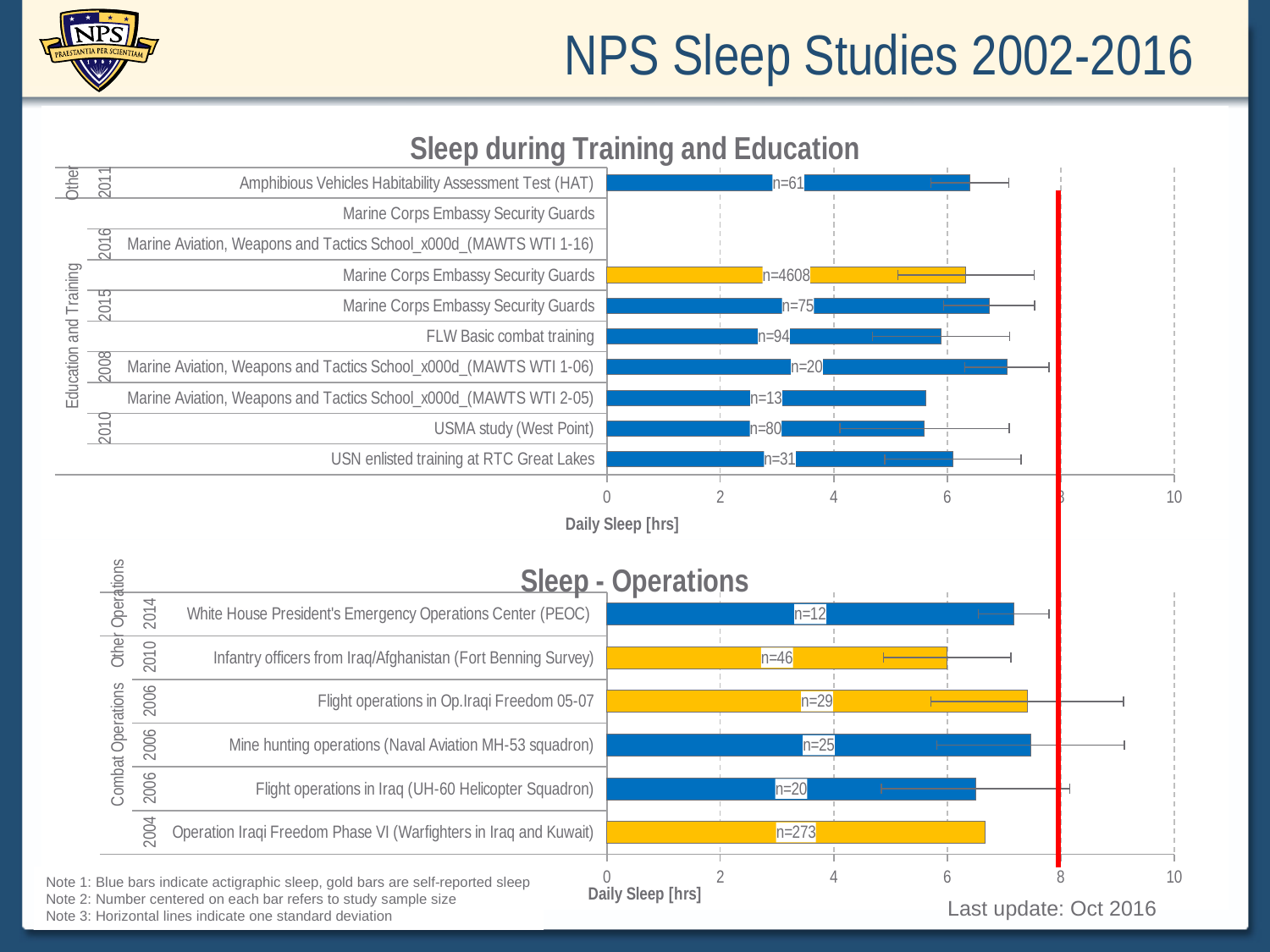
In the "Sleep during Training and Education" chart, which has the higher daily sleep: Marine Aviation, Weapons and Tactics School (MAWTS WTI 1-06) or USMA study (West Point)? Marine Aviation, Weapons and Tactics School (MAWTS WTI 1-06) In the "Sleep - Operations" chart, which category has the lowest daily sleep? Infantry officers from Iraq/Afghanistan (Fort Benning Survey) What kind of chart is the "Sleep - Operations" chart? bar chart In the "Sleep during Training and Education" chart, is the daily sleep value for USMA study (West Point) greater or less than 6? less In the "Sleep - Operations" chart, how many categories are plotted? 6 In the "Sleep - Operations" chart, which has the higher daily sleep: White House President's Emergency Operations Center (PEOC) or Infantry officers from Iraq/Afghanistan (Fort Benning Survey)? White House President's Emergency Operations Center (PEOC) In the "Sleep during Training and Education" chart, is the daily sleep value for Marine Aviation, Weapons and Tactics School (MAWTS WTI 1-06) greater or less than 6? greater In the "Sleep - Operations" chart, what is the sample size (n) shown on the bar for Operation Iraqi Freedom Phase VI (Warfighters in Iraq and Kuwait)? n=273 In the "Sleep during Training and Education" chart, what is the sample size (n) shown on the gold bar for Marine Corps Embassy Security Guards? n=4608 What is the x-axis label of the "Sleep - Operations" chart? Daily Sleep [hrs] In the "Sleep - Operations" chart, is the daily sleep value for Flight operations in Iraq (UH-60 Helicopter Squadron) greater or less than 6? greater In the "Sleep - Operations" chart, what is the sample size (n) shown on the bar for White House President's Emergency Operations Center (PEOC)? n=12